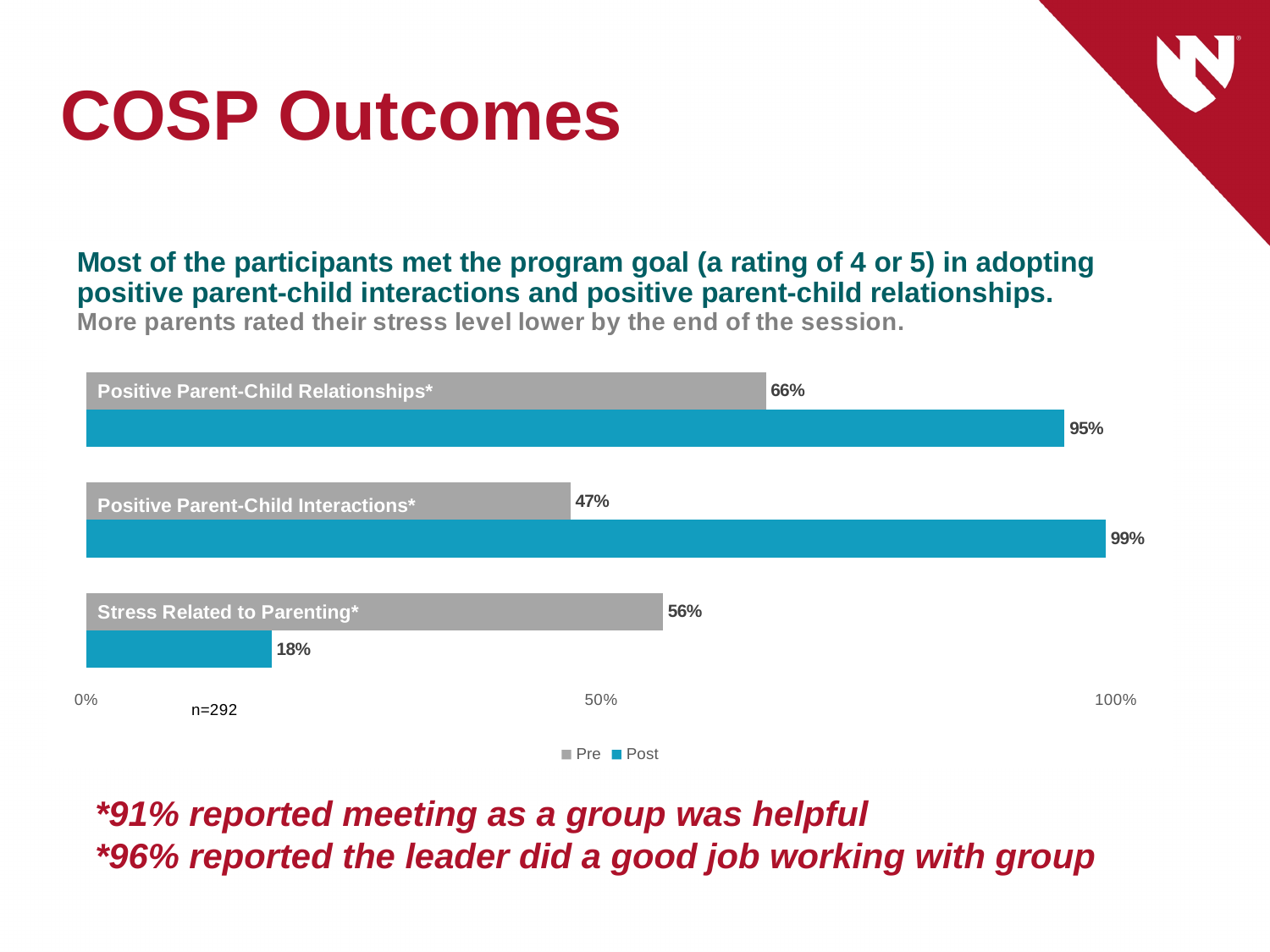
What is the Post value for Stress Related to Parenting*? 18% What is the Post value for Positive Parent-Child Relationships*? 95% What kind of chart is shown on the slide? Bar chart Which category has the lowest Pre value? Positive Parent-Child Interactions* Which is larger for Stress Related to Parenting*, the Pre value or the Post value? Pre What is the difference between the Post and Pre values for Positive Parent-Child Interactions*? 52% Which category has the highest Post value? Positive Parent-Child Interactions* How many series does the legend list? 2 Is the Pre value for Positive Parent-Child Relationships* greater or less than 50%? greater How many categories are shown in the chart? 3 What is the Pre value for Stress Related to Parenting*? 56% What is the Pre value for Positive Parent-Child Interactions*? 47%